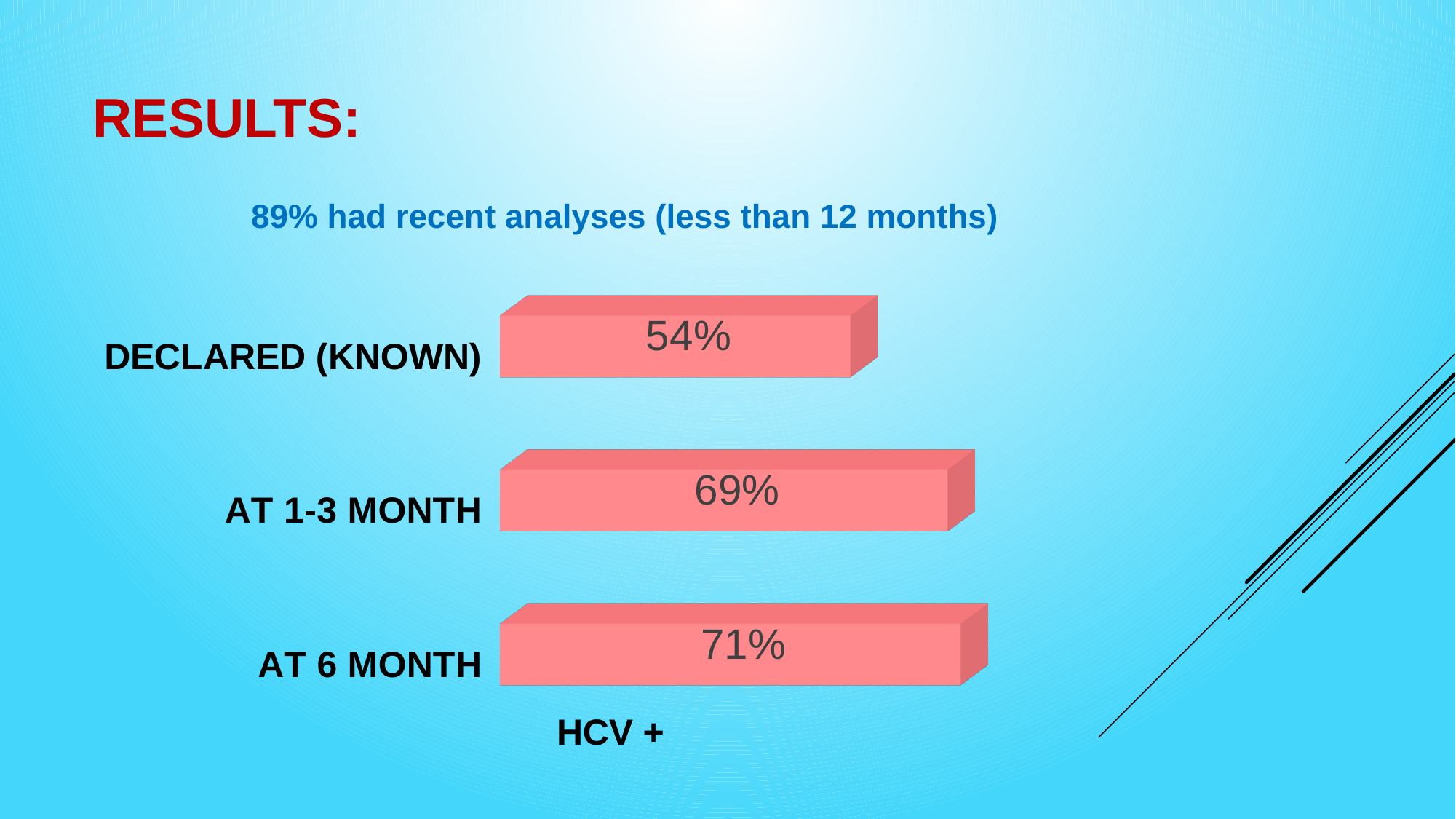
What is the label shown below the bars of the chart? HCV + Which is larger, the value for AT 1-3 MONTH or the value for DECLARED (KNOWN)? AT 1-3 MONTH What is the difference between the values for AT 6 MONTH and DECLARED (KNOWN)? 17% What colour are the bars in the chart? pink/red What is the value for DECLARED (KNOWN)? 54% What is the value for AT 1-3 MONTH? 69% How many categories are shown in the chart? 3 What is the difference between the values for AT 1-3 MONTH and DECLARED (KNOWN)? 15% Which category has the highest value? AT 6 MONTH Which category has the lowest value? DECLARED (KNOWN) What kind of chart is shown on the slide? bar chart What is the value for AT 6 MONTH? 71%